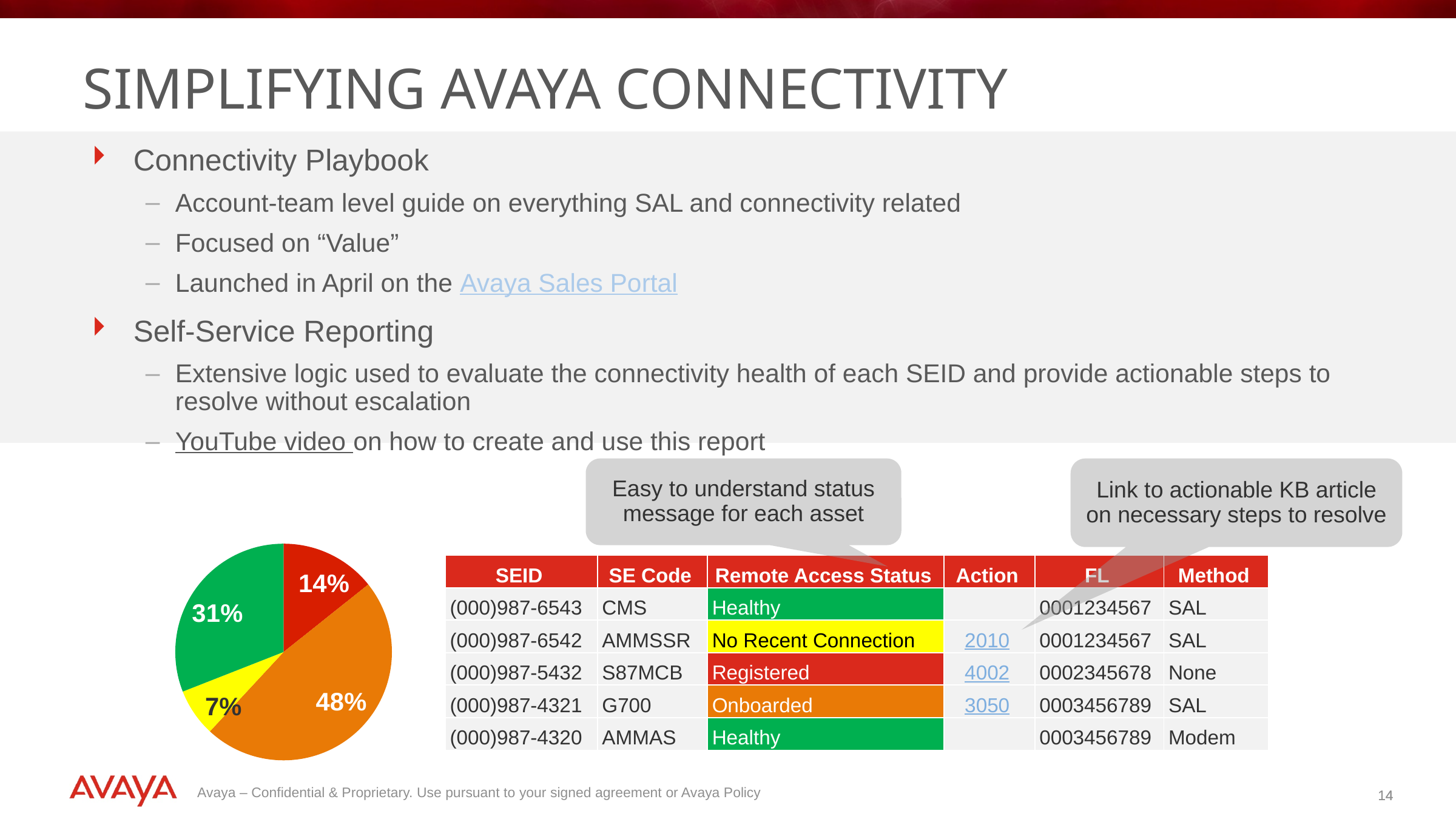
What percentage is shown on the green slice of the pie chart? 31% What kind of chart is shown at the bottom left of the slide? pie chart Which is larger in the pie chart, the green slice or the red slice? the green slice Is the value of the orange slice in the pie chart greater or less than 40%? greater What percentage is shown on the red slice of the pie chart? 14% What is the difference in percentage points between the orange slice and the green slice of the pie chart? 17 percentage points What share of the pie does the orange slice represent? 48% Does the pie chart include a legend naming its slices? No What is the difference in percentage points between the red slice and the yellow slice of the pie chart? 7 percentage points Which slice of the pie chart is the largest? the orange slice (48%) How many slices does the pie chart have? 4 Which slice of the pie chart is the smallest? the yellow slice (7%)